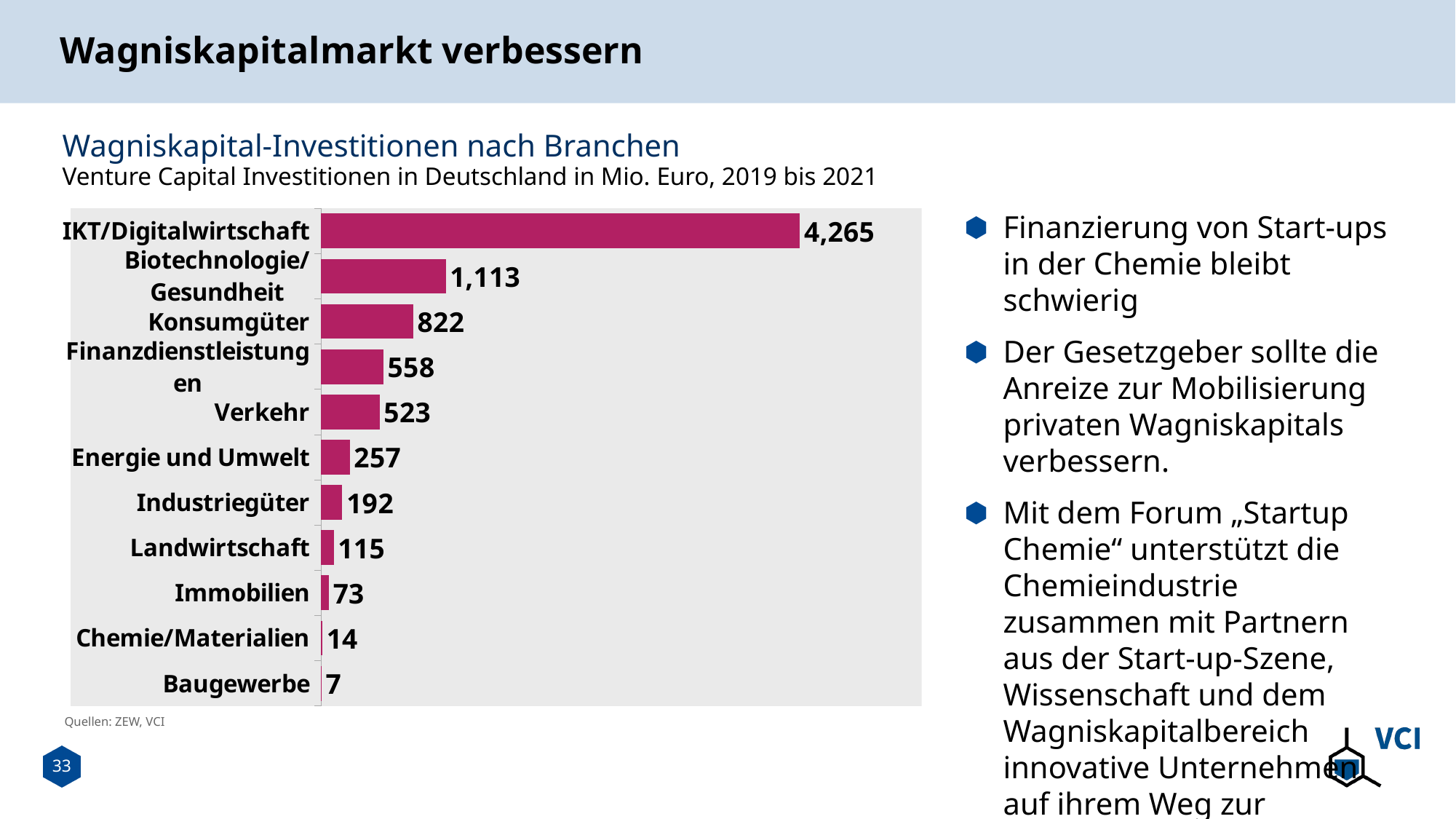
What is the difference between the values for IKT/Digitalwirtschaft and Biotechnologie/Gesundheit? 3,152 What is the difference between the values for Finanzdienstleistungen and Verkehr? 35 Which sector has the highest venture capital investment? IKT/Digitalwirtschaft Which has a larger value, Immobilien or Chemie/Materialien? Immobilien How many sectors are shown in the chart? 11 What kind of chart is shown on the slide? Bar chart Which sector has the lowest venture capital investment? Baugewerbe What is the value shown for Chemie/Materialien? 14 What is the venture capital investment value for Konsumgüter? 822 What is the title of the chart? Wagniskapital-Investitionen nach Branchen What is the value shown for Energie und Umwelt? 257 Which has a larger value, Industriegüter or Landwirtschaft? Industriegüter